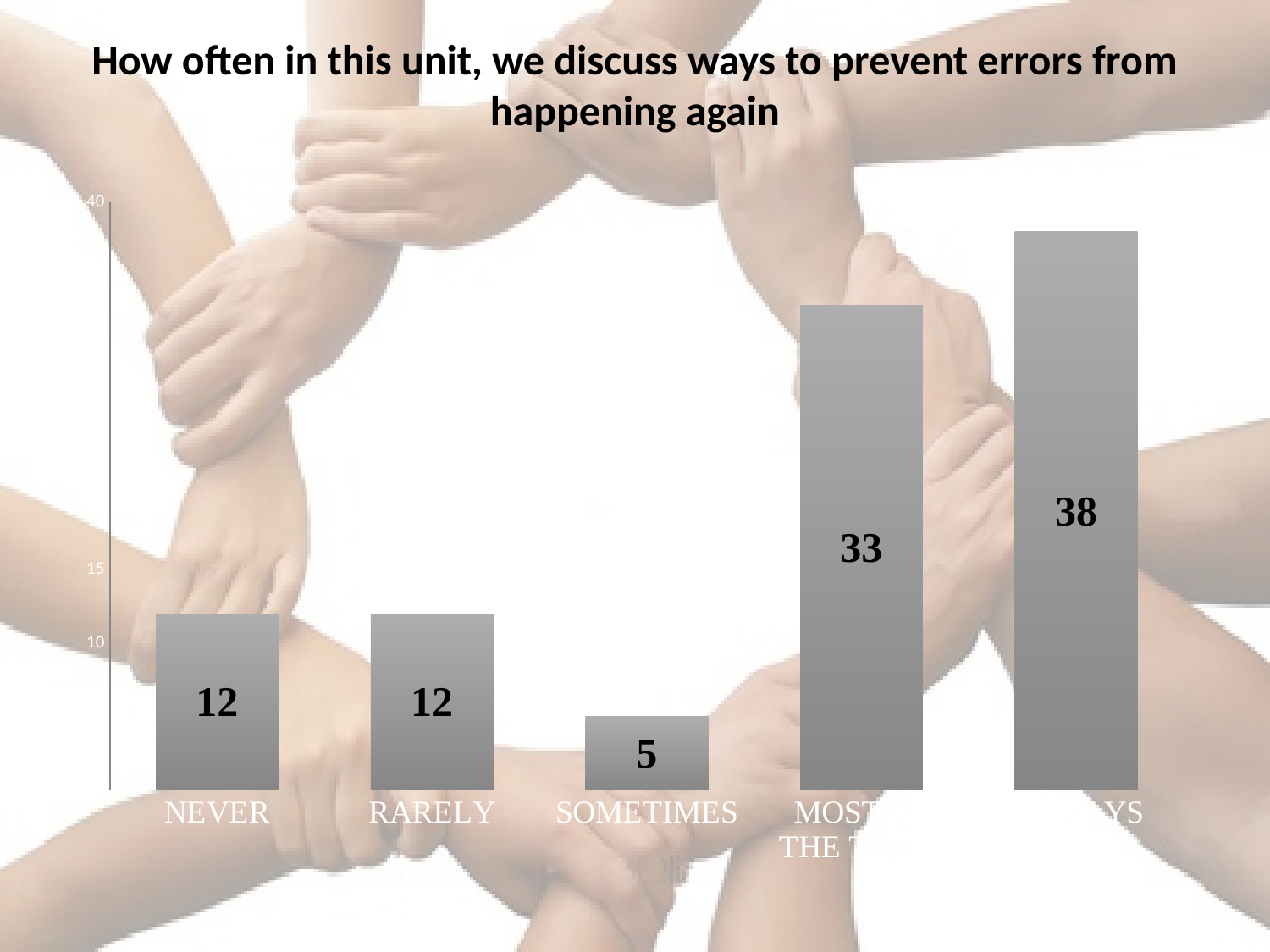
What is the value shown on the rightmost bar? 38 Which category has the lowest value? SOMETIMES What is the highest value shown on any bar? 38 What is the difference between the value for NEVER and the value for SOMETIMES? 7 Is the value for SOMETIMES greater or less than 10? less How many bars are in the chart? 5 What kind of chart is shown on the slide? bar chart What is the value for SOMETIMES? 5 What is the difference between the rightmost bar and the fourth bar from the left? 5 What is the value shown on the fourth bar from the left? 33 What is the value for RARELY? 12 What is the value for NEVER? 12